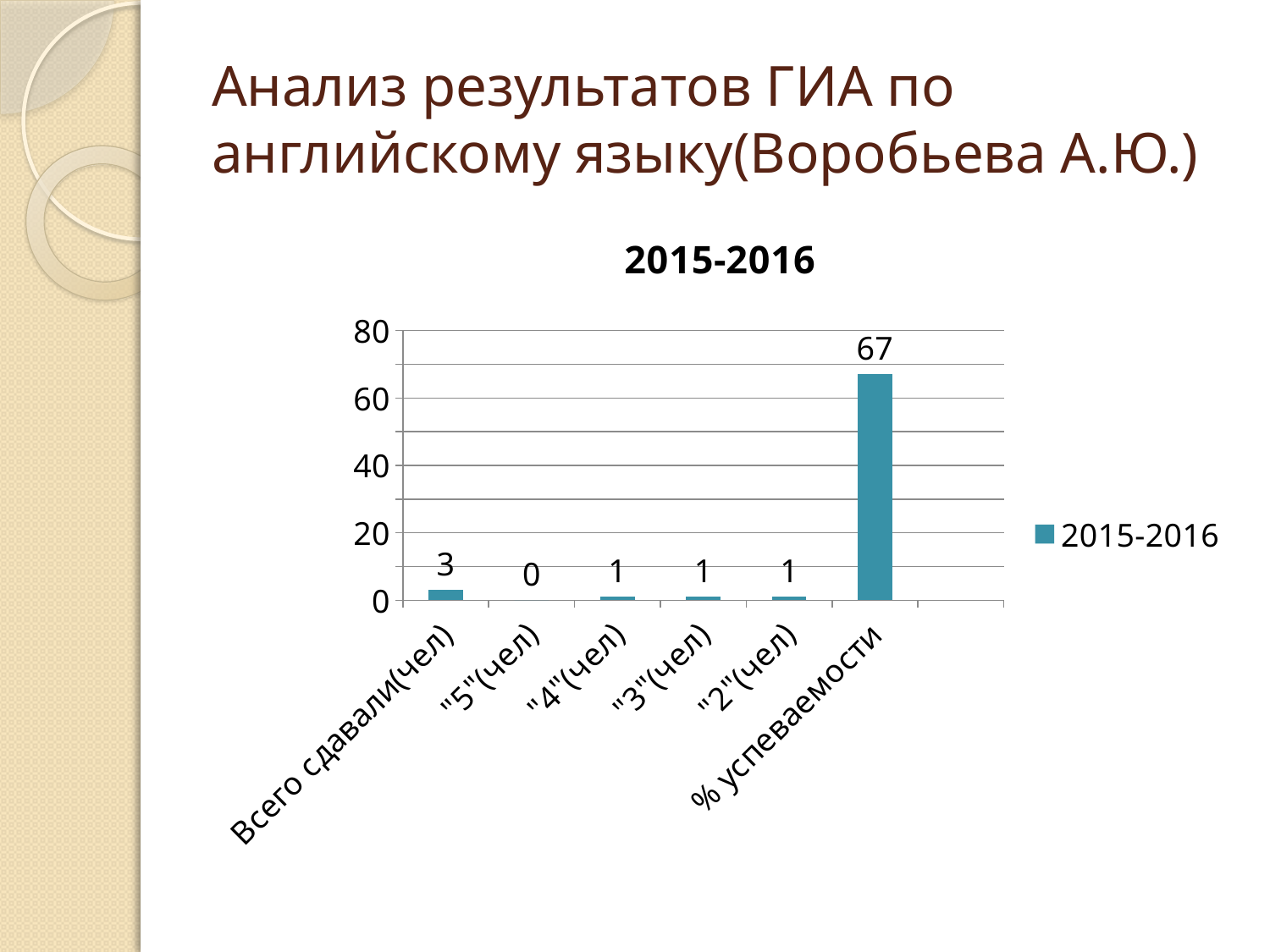
What is the difference between the value for "% успеваемости" and the value for "Всего сдавали(чел)"? 64 What is the value for "% успеваемости"? 67 How many categories are shown on the x axis? 6 Which is larger, the value for "Всего сдавали(чел)" or the value for "3"(чел)? Всего сдавали(чел) What is the value for "Всего сдавали(чел)"? 3 Which category has the lowest value? "5"(чел) How many series does the legend list? 1 Is the value for "% успеваемости" greater or less than 60? greater What is the value for "5"(чел)? 0 What is the value for "4"(чел)? 1 Which category has the highest value? % успеваемости What type of chart is shown? bar chart